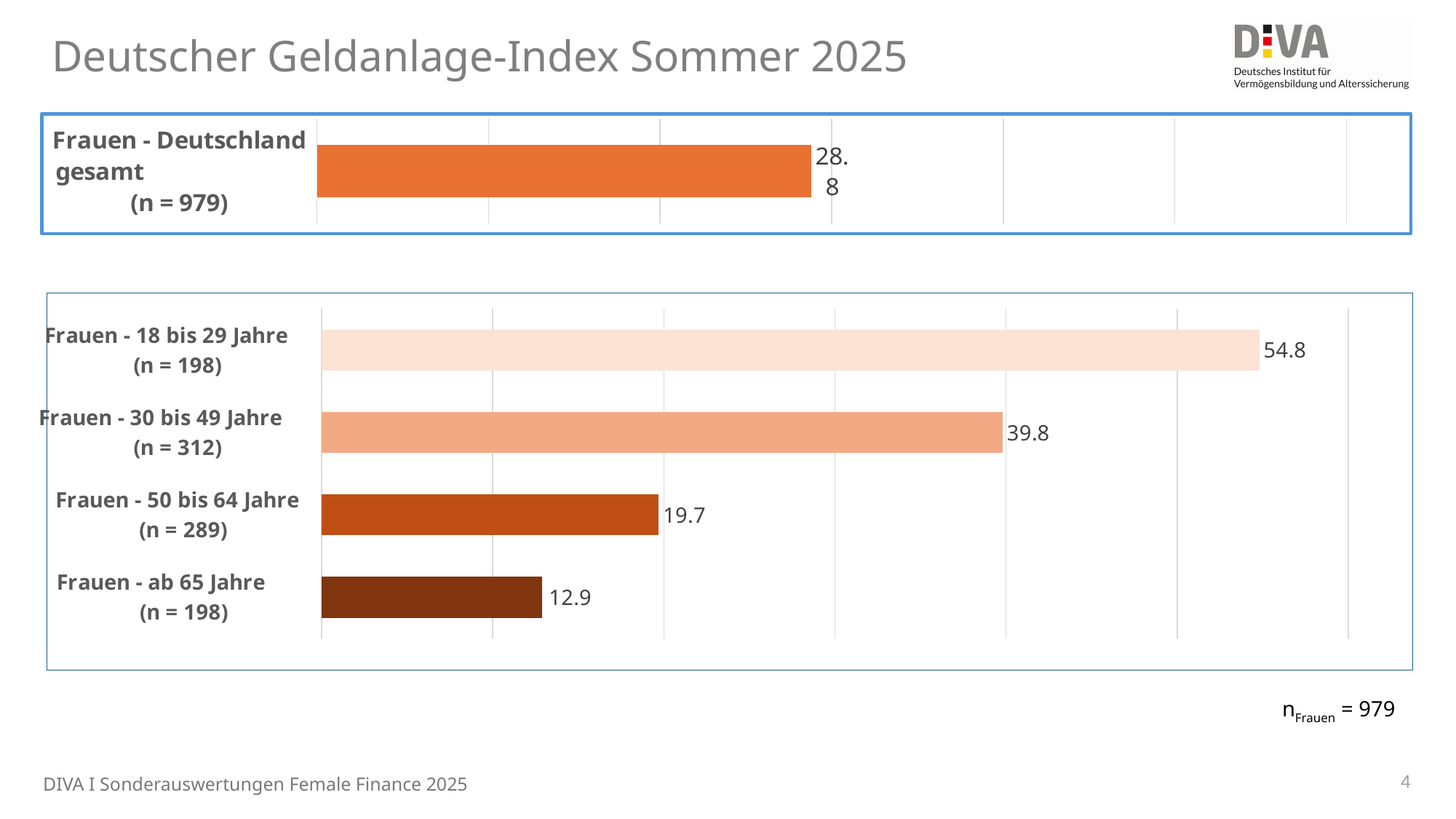
In the top chart, what is the value for Frauen - Deutschland gesamt? 28.8 In the bottom chart, what is the difference between the values for Frauen - 18 bis 29 Jahre and Frauen - ab 65 Jahre? 41.9 In the bottom chart, which age group has the lowest value? Frauen - ab 65 Jahre In the bottom chart, which is larger: the value for Frauen - 30 bis 49 Jahre or Frauen - 50 bis 64 Jahre? Frauen - 30 bis 49 Jahre In the bottom chart, what is the value for Frauen - 18 bis 29 Jahre? 54.8 How many age groups are shown in the bottom chart? 4 In the bottom chart, do the values rise or fall as the age groups get older from top to bottom? Fall In the bottom chart, which age group has the highest value? Frauen - 18 bis 29 Jahre In the bottom chart, what is the value for Frauen - ab 65 Jahre? 12.9 In the bottom chart, what is the value for Frauen - 30 bis 49 Jahre? 39.8 In the bottom chart, what is the value for Frauen - 50 bis 64 Jahre? 19.7 What kind of chart is the bottom chart? Bar chart